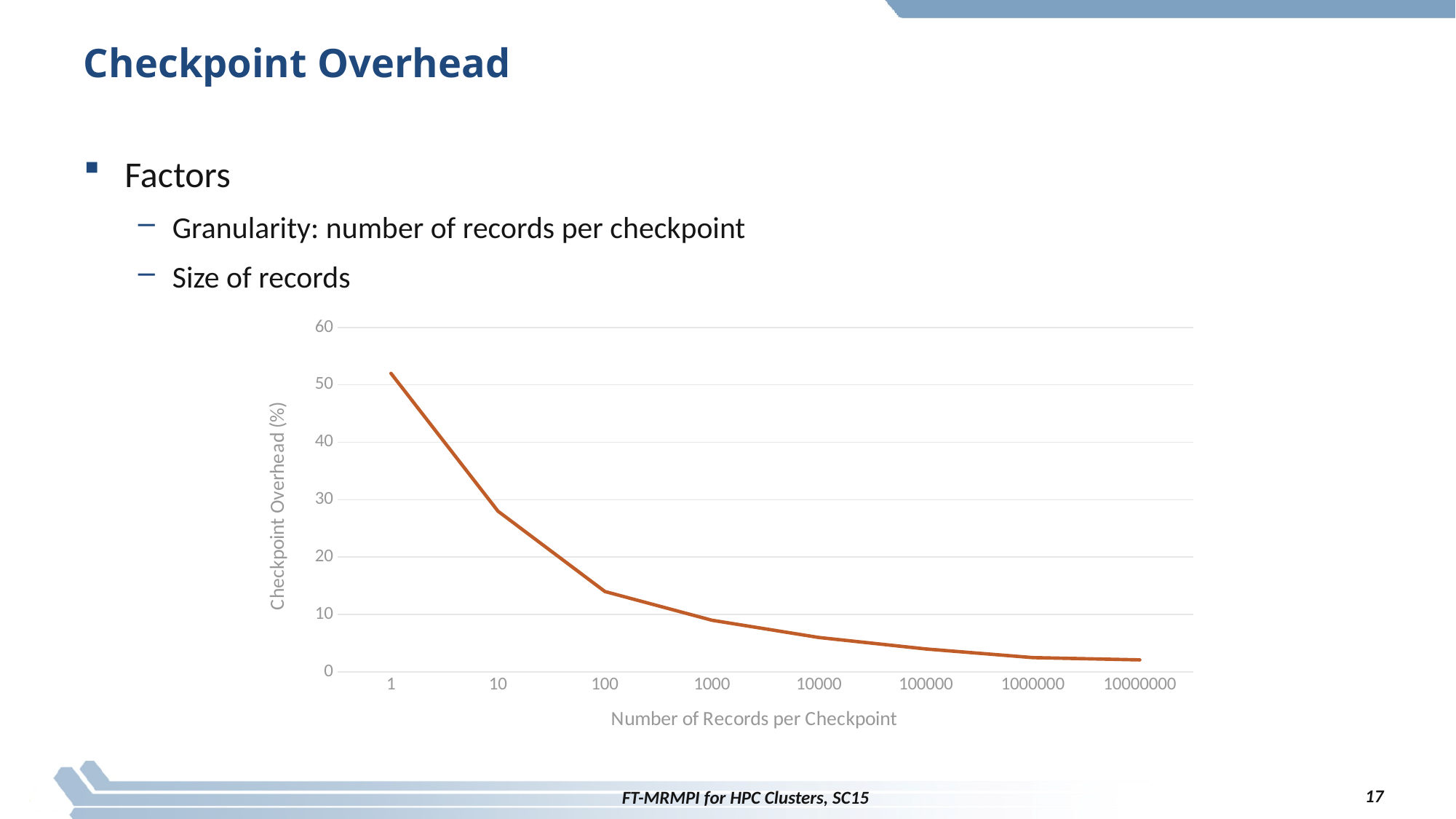
What is the label of the y axis? Checkpoint Overhead (%) Is the checkpoint overhead at 10000 records per checkpoint greater or less than 10? less What is the label of the x axis? Number of Records per Checkpoint At which number of records per checkpoint is the checkpoint overhead highest? 1 How many data points are plotted along the x axis? 8 Do the values rise or fall as the number of records per checkpoint increases? fall What kind of chart is shown on the slide? line chart Is the checkpoint overhead at 1 record per checkpoint greater or less than 40? greater Which has a higher checkpoint overhead: 10 records per checkpoint or 100 records per checkpoint? 10 Is the checkpoint overhead at 100 records per checkpoint greater or less than 10? greater